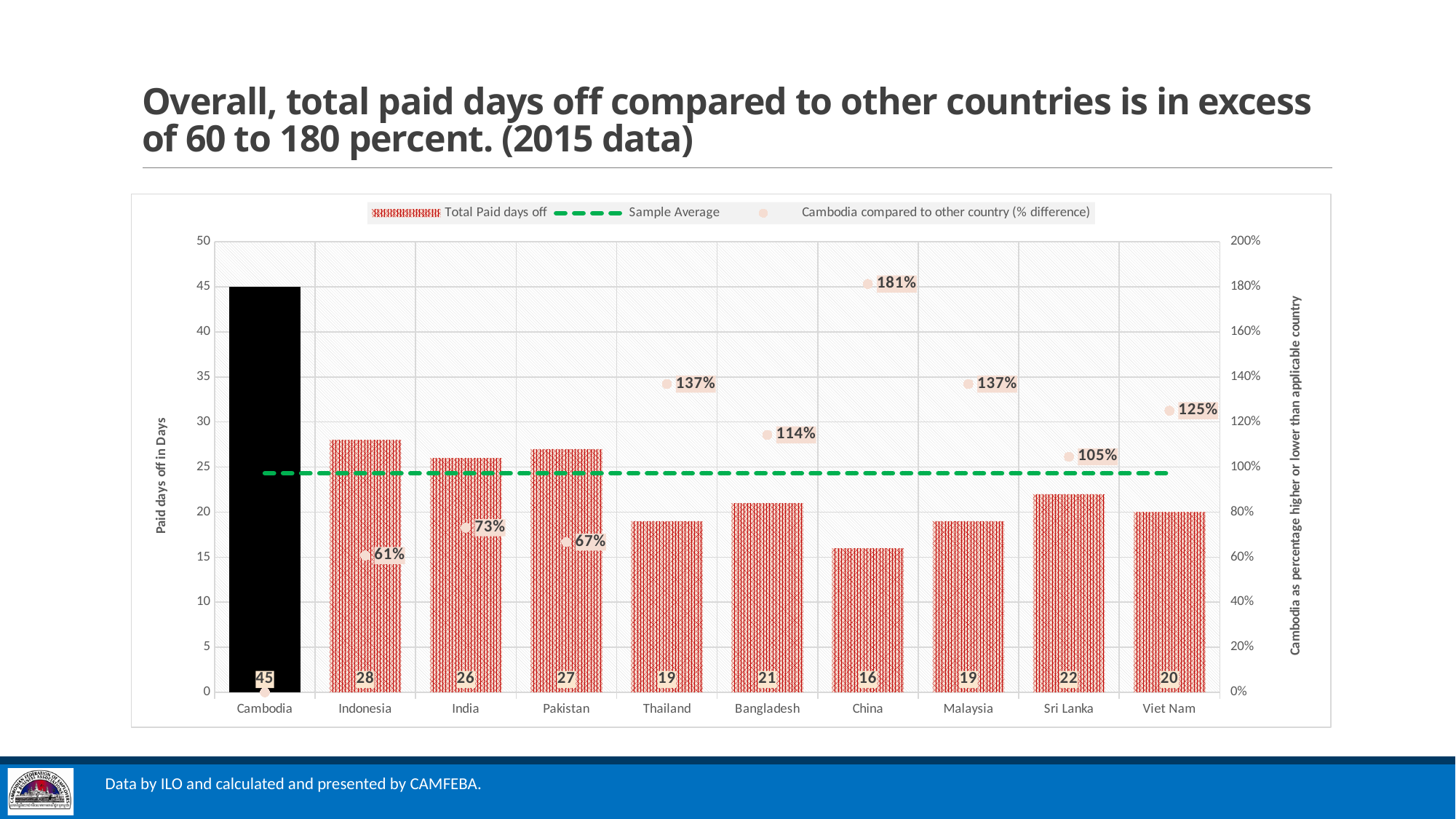
What is the percentage difference shown for China (Cambodia compared to other country)? 181% What is the difference in total paid days off between Cambodia and China? 29 What is the label of the right-hand vertical axis? Cambodia as percentage higher or lower than applicable country Which has more total paid days off, Pakistan or India? Pakistan What is the total paid days off for Cambodia? 45 What is the percentage difference shown for Sri Lanka? 105% How many countries are shown on the x axis? 10 Which country has the lowest total paid days off? China How many series does the legend list? 3 Is the Sample Average line greater or less than 20 days? greater Which country has the highest total paid days off? Cambodia What is the total paid days off for Indonesia? 28